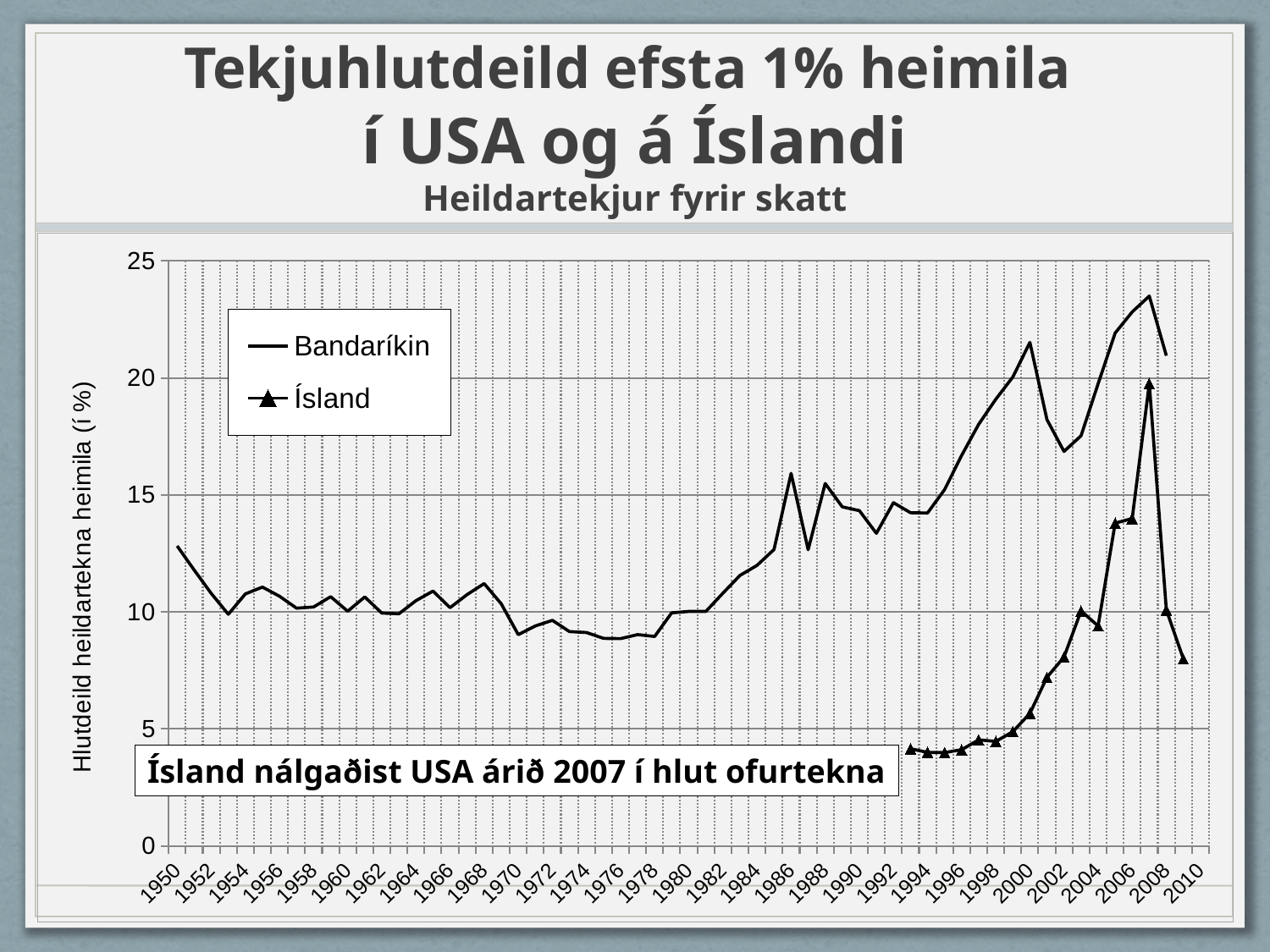
In which year does the Ísland series reach its highest value? 2007 Is the value for Bandaríkin in 1976 greater or less than 10? less Is the value for Ísland in 1993 greater or less than 5? less How many series does the legend list? 2 Is the value for Bandaríkin in 2007 greater or less than 20? greater What is the label of the vertical axis? Hlutdeild heildartekna heimila (í %) Does the Ísland series rise or fall between 1993 and 2007? rise What are the two series named in the legend? Bandaríkin and Ísland What kind of chart is shown on the slide? line chart In 2007, which series has the higher value, Bandaríkin or Ísland? Bandaríkin